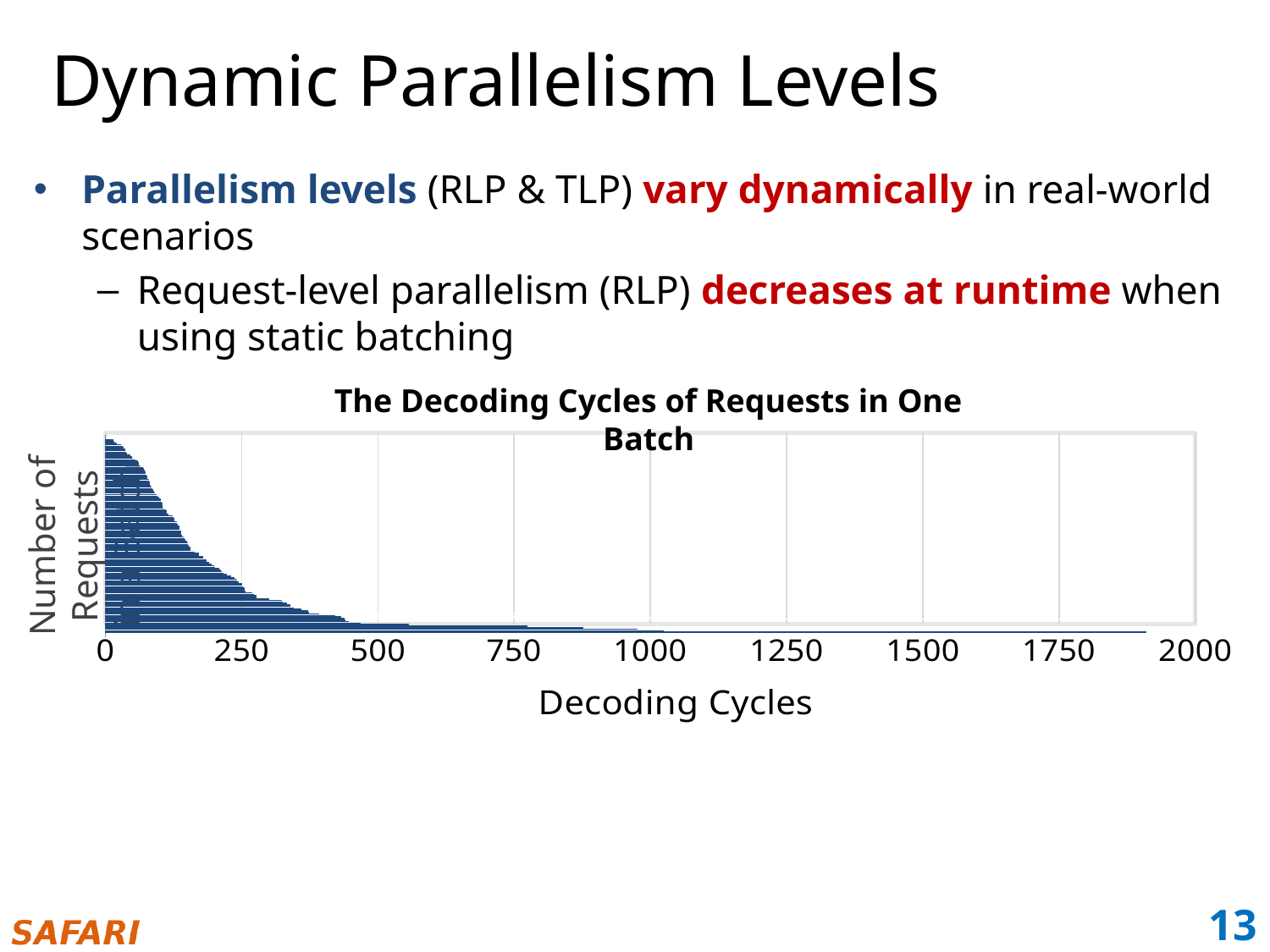
What is the title of the chart? The Decoding Cycles of Requests in One Batch What is the label of the x axis of the chart? Decoding Cycles Is the value for the longest bar in the chart greater or less than 2000? less What kind of chart is shown on the slide? bar chart Do the bar lengths increase or decrease going from the top of the chart to the bottom? increase Is the value for the longest bar in the chart greater or less than 1750? greater Are most of the bars in the chart greater or less than 500 decoding cycles? less